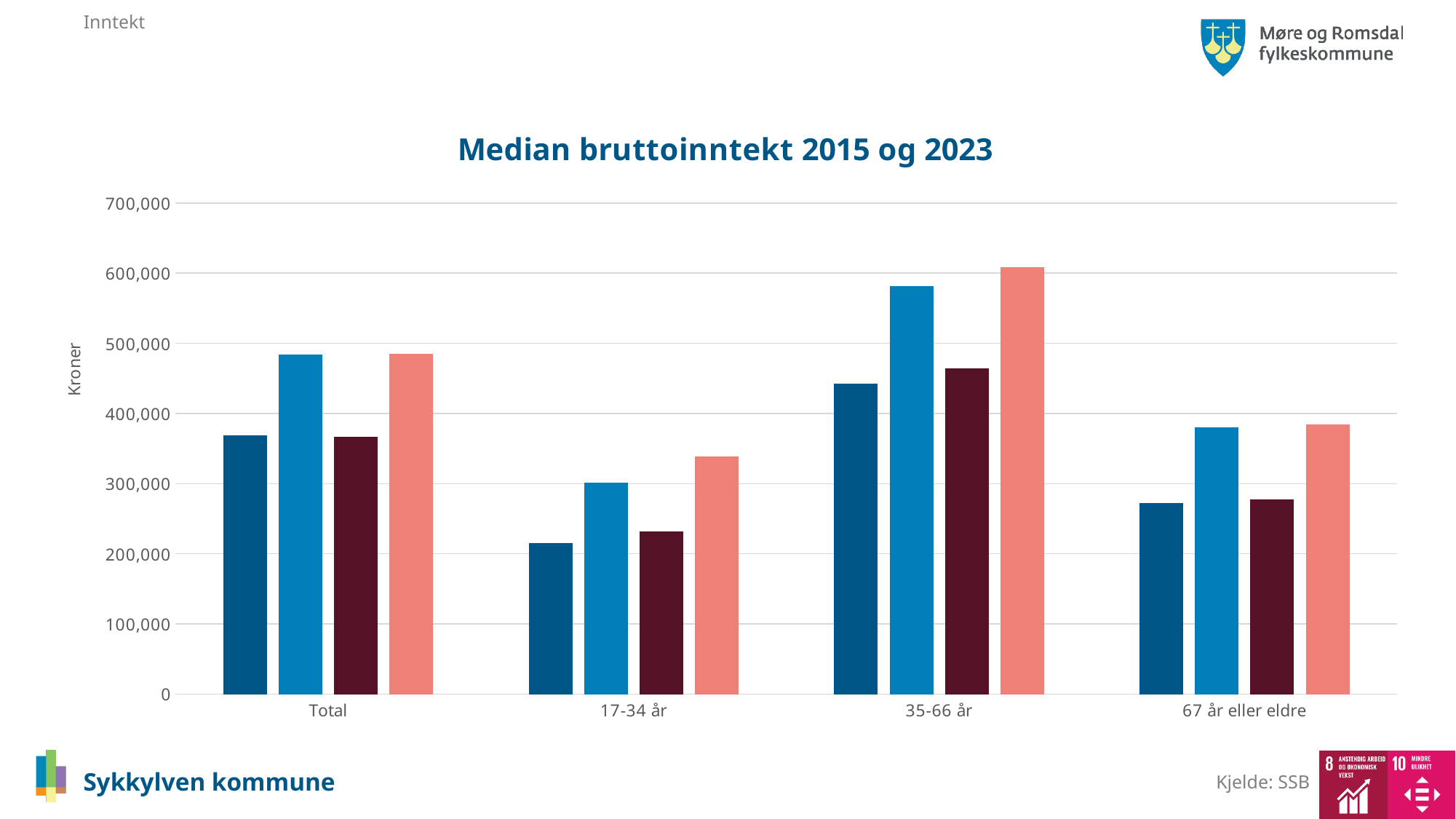
What is the label on the vertical axis of the chart? Kroner What kind of chart is shown on the slide? bar chart Is the value of the third (dark red) bar for 67 år eller eldre greater or less than 300,000? less How many categories are shown on the x axis of the chart? 4 Within the 17-34 år group, which is taller: the first (dark blue) bar or the second (light blue) bar? the second (light blue) bar Which category contains the shortest bar in the chart? 17-34 år Is the value of the first (dark blue) bar for 17-34 år greater or less than 300,000? less Which category contains the tallest bar in the chart? 35-66 år How many bars are plotted for each category in the chart? 4 Is the value of the second (light blue) bar for Total greater or less than 400,000? greater What is the title of the chart? Median bruttoinntekt 2015 og 2023